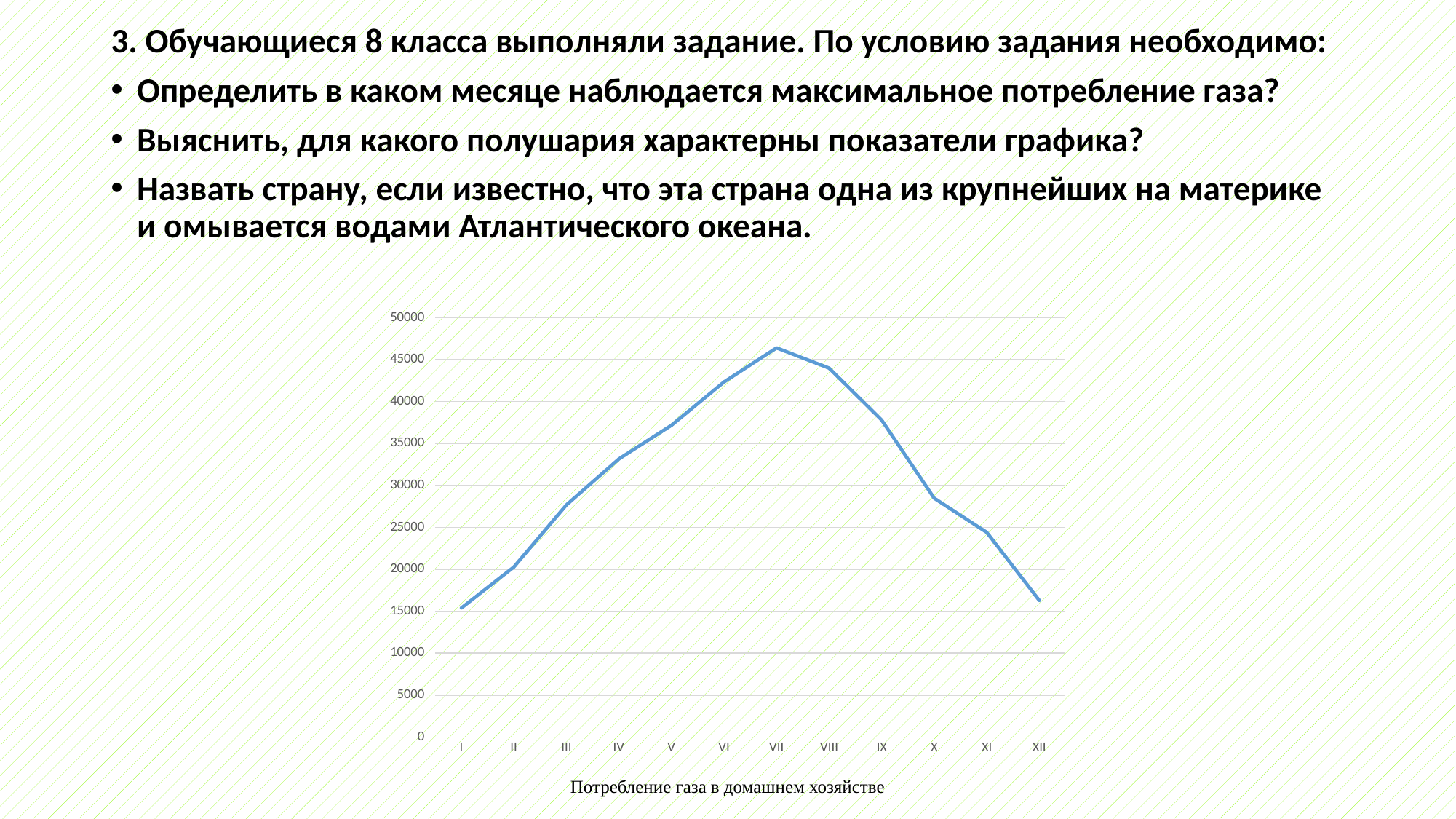
Do the values rise or fall from month VII to month XII? fall What is the title shown below the chart? Потребление газа в домашнем хозяйстве Which month has the larger value, VI or IX? VI Is the value for month XII greater or less than 20000? less In which month does the chart show the highest gas consumption? VII Is the value for month VII greater or less than 45000? greater How many months (points) are plotted along the x axis of the chart? 12 Which month has the larger value, III or XI? III Is the value for month IV greater or less than 30000? greater What kind of chart is shown on the slide? line chart